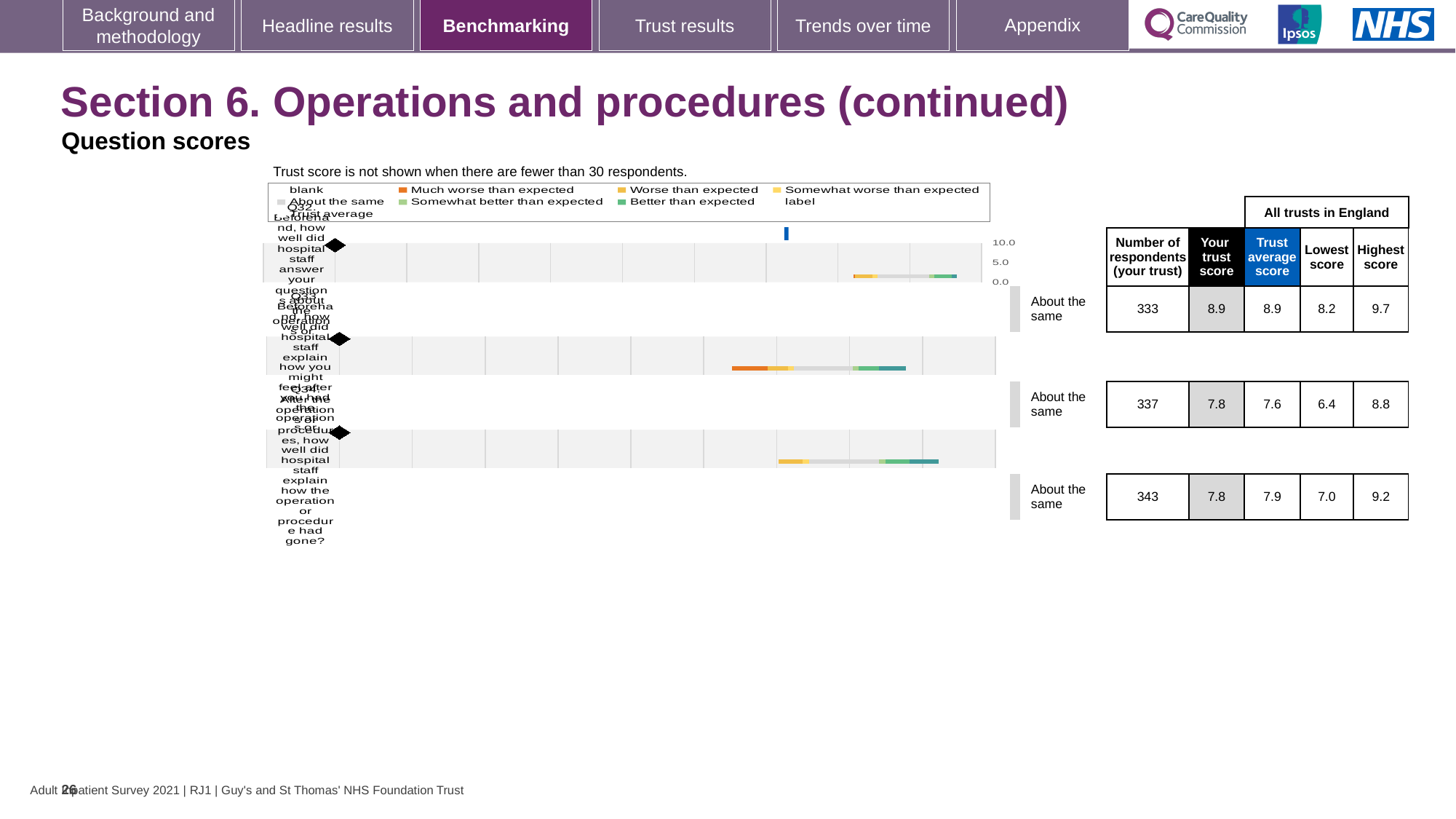
What is the lowest score across all trusts in England for the third question (Q34)? 7.0 What is the difference between the trust average score and the trust's own score for the third question (Q34)? 0.1 What is the 'Your trust score' value for the first question (Q32)? 8.9 What is the number of respondents for the first question (Q32)? 333 For the second question (Q33), which is larger: the trust's own score or the trust average score? Your trust score (7.8) Which question has the lowest 'Lowest score' value? Q33 (6.4) What benchmark category is shown for all three questions? About the same What kind of chart is shown on the slide? bar chart How many questions (rows) are plotted in the chart? 3 What is the highest score across all trusts in England for the second question (Q33)? 8.8 Which question has the highest number of respondents? Q34 (343) What is the difference between the highest score and the lowest score for the first question (Q32)? 1.5